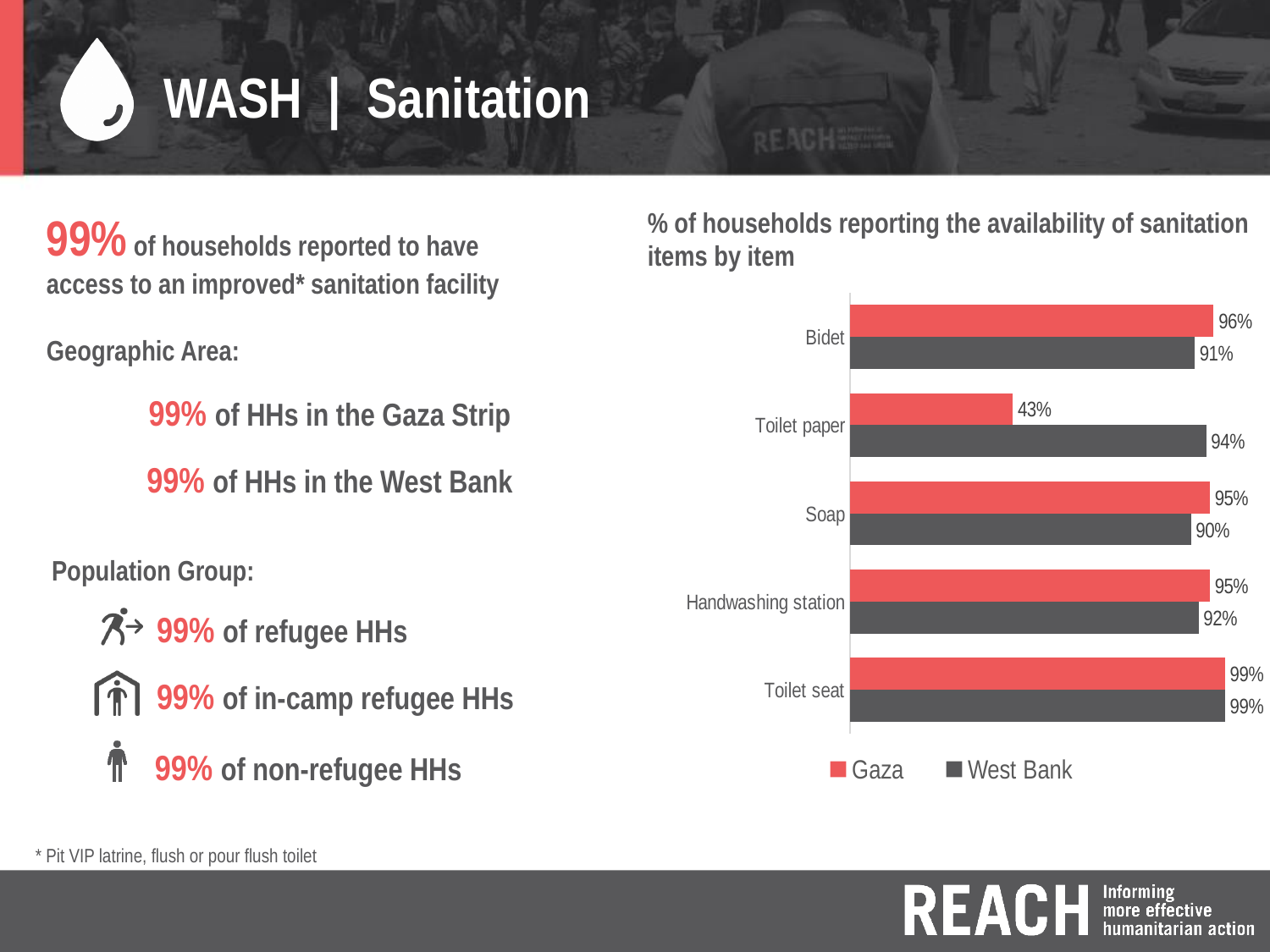
Which colour represents Gaza in the chart? Red For soap, which area has the higher reported availability, Gaza or the West Bank? Gaza Which sanitation item has the lowest reported availability among Gaza households? Toilet paper What percentage of households in Gaza reported the availability of toilet paper? 43% Which sanitation item has the highest reported availability among West Bank households? Toilet seat What is the difference between the West Bank and Gaza values for toilet paper? 51 percentage points How many sanitation items are shown in the chart? 5 What percentage of households in the West Bank reported the availability of a bidet? 91% What percentage of households in Gaza reported the availability of a handwashing station? 95% What type of chart is used to show the availability of sanitation items? Bar chart What percentage of households in the West Bank reported the availability of soap? 90% How many series does the chart legend list? 2